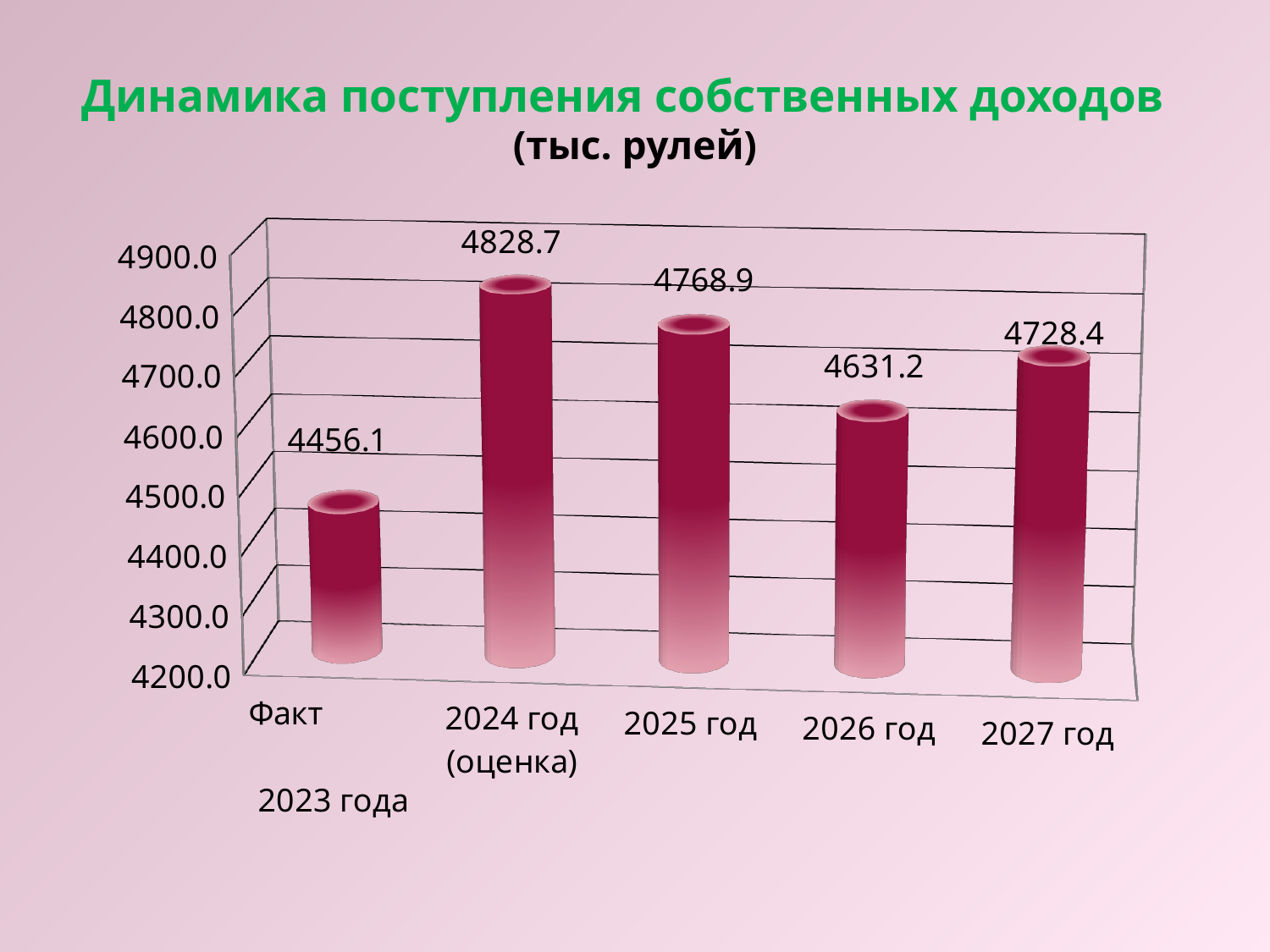
What is the value for 2024 год (оценка)? 4828.7 What is the difference between the values for 2024 год (оценка) and Факт 2023 года? 372.6 Which category has the lowest value? Факт 2023 года What is the value for 2026 год? 4631.2 What is the title of the chart? Динамика поступления собственных доходов (тыс. рулей) Which category has the highest value? 2024 год (оценка) What is the value for 2027 год? 4728.4 What kind of chart is shown on the slide? Bar chart Which is larger, the value for 2025 год or the value for 2027 год? 2025 год What is the value for Факт 2023 года? 4456.1 How many categories are shown on the chart? 5 What is the difference between the values for 2025 год and 2026 год? 137.7